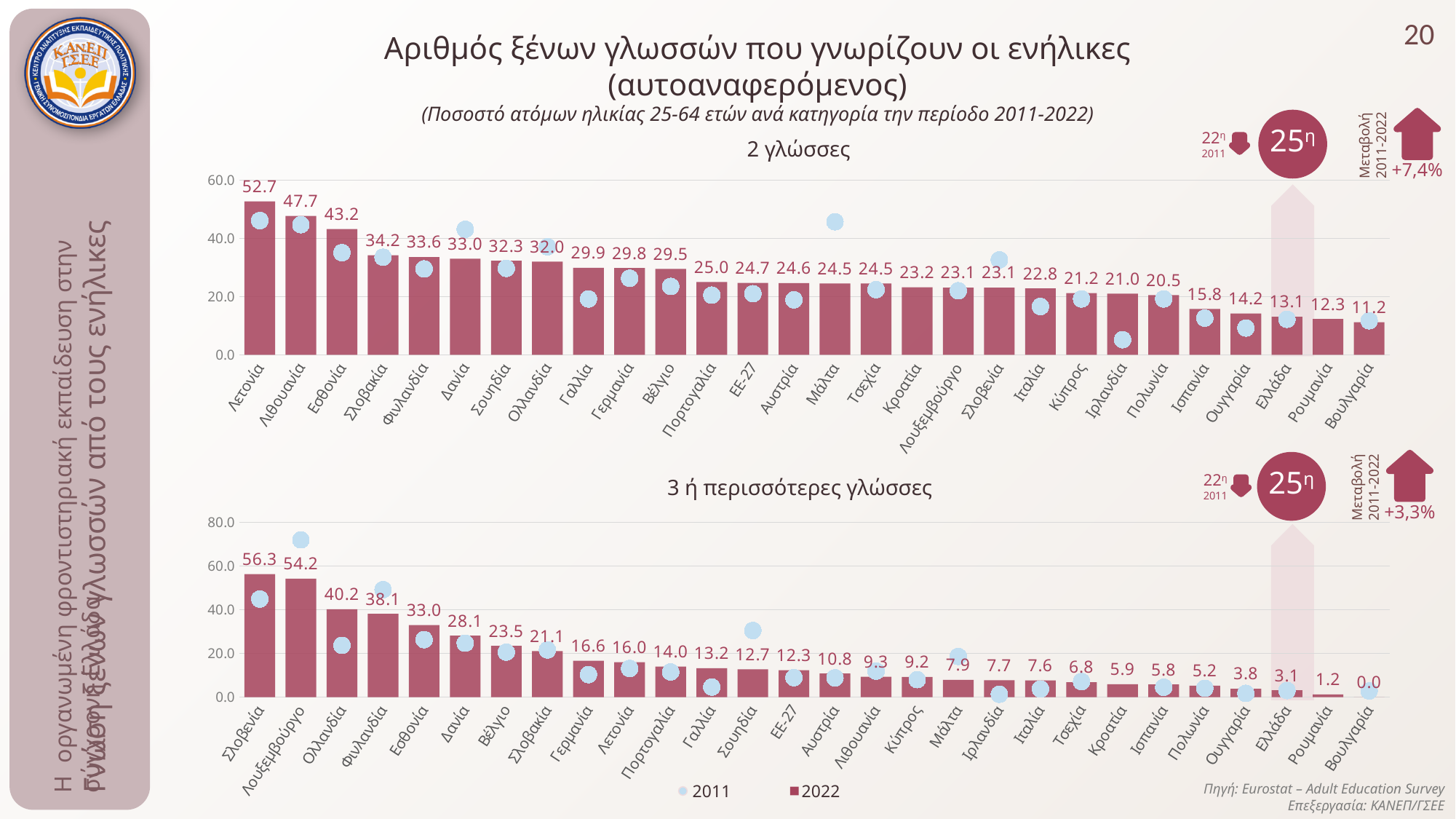
How many countries/categories are shown in the '2 γλώσσες' chart? 28 In the '2 γλώσσες' chart, what is the 2022 value for Ελλάδα? 13.1 In the '3 ή περισσότερες γλώσσες' chart, which country has the lowest 2022 value? Βουλγαρία In the '3 ή περισσότερες γλώσσες' chart, which has the larger 2022 value, Ολλανδία or Φινλανδία? Ολλανδία In the '2 γλώσσες' chart, what is the difference between the 2022 values for Λετονία and Λιθουανία? 5.0 In the '3 ή περισσότερες γλώσσες' chart, is the 2011 value (dot) for Λουξεμβούργο greater or less than 60.0? greater In the '2 γλώσσες' chart, which country has the highest 2022 value? Λετονία How many series does the legend list? 2 In the '2 γλώσσες' chart, which country has the lowest 2022 value? Βουλγαρία In the '2 γλώσσες' chart, what is the 2022 value for ΕΕ-27? 24.7 What kind of chart is the '3 ή περισσότερες γλώσσες' chart? Bar chart (with dot markers for 2011) In the '3 ή περισσότερες γλώσσες' chart, what is the 2022 value for Σλοβενία? 56.3